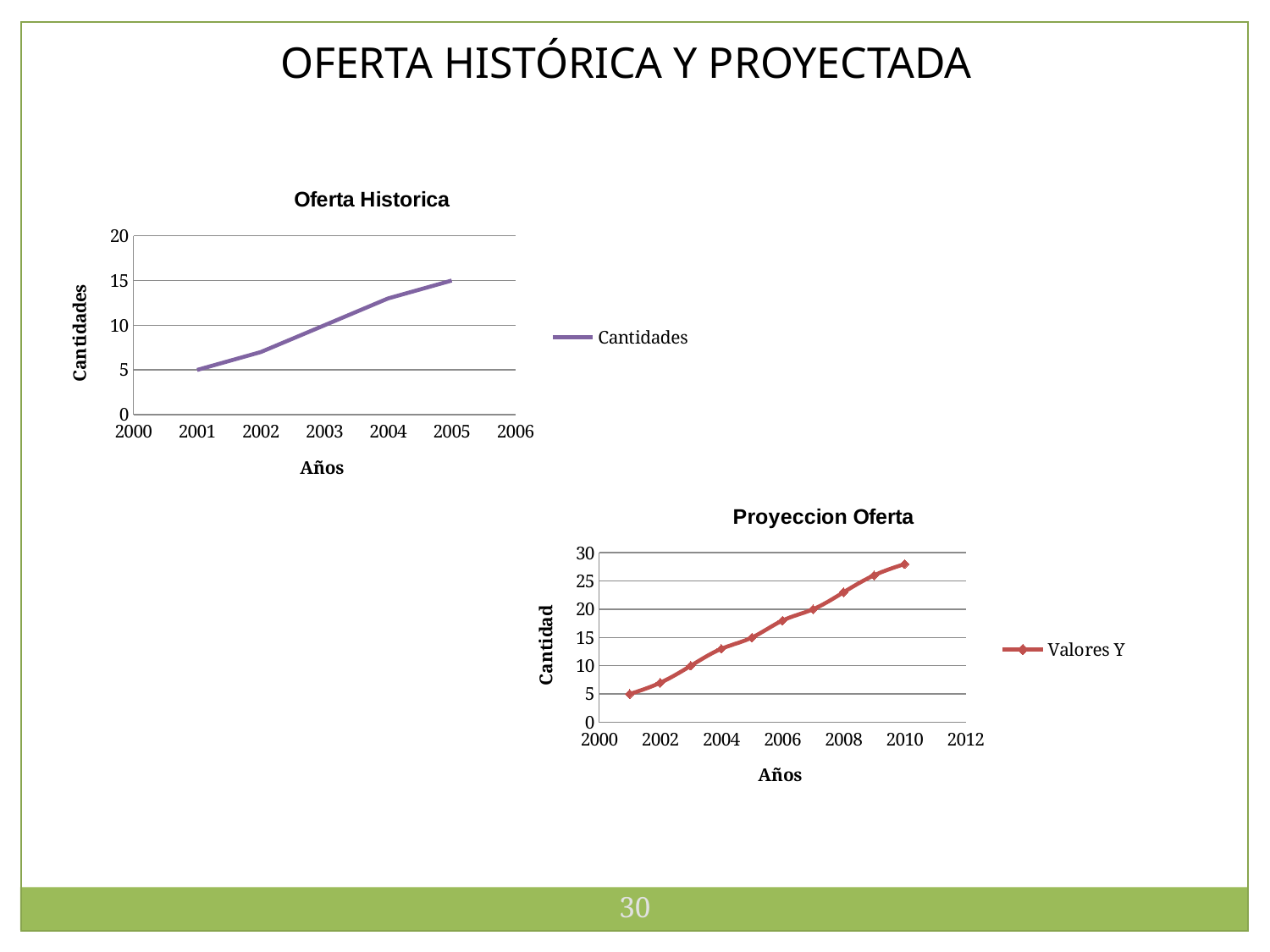
In the "Oferta Historica" chart, do the values rise or fall from 2001 to 2005? rise In the "Oferta Historica" chart, what is the value for 2005? 15 In the "Oferta Historica" chart, is the value for 2004 greater or less than 10? greater In the "Oferta Historica" chart, what is the value for 2001? 5 What kind of chart is the "Oferta Historica" chart? line chart How many series does the legend of the "Oferta Historica" chart list? 1 In the "Proyeccion Oferta" chart, what is the value for 2007? 20 In the "Proyeccion Oferta" chart, which year has the highest value? 2010 In the "Proyeccion Oferta" chart, is the value for 2010 greater or less than 25? greater In the "Proyeccion Oferta" chart, is the value for 2002 greater or less than 10? less How many data points are plotted in the "Proyeccion Oferta" chart? 10 What is the legend entry of the "Proyeccion Oferta" chart? Valores Y